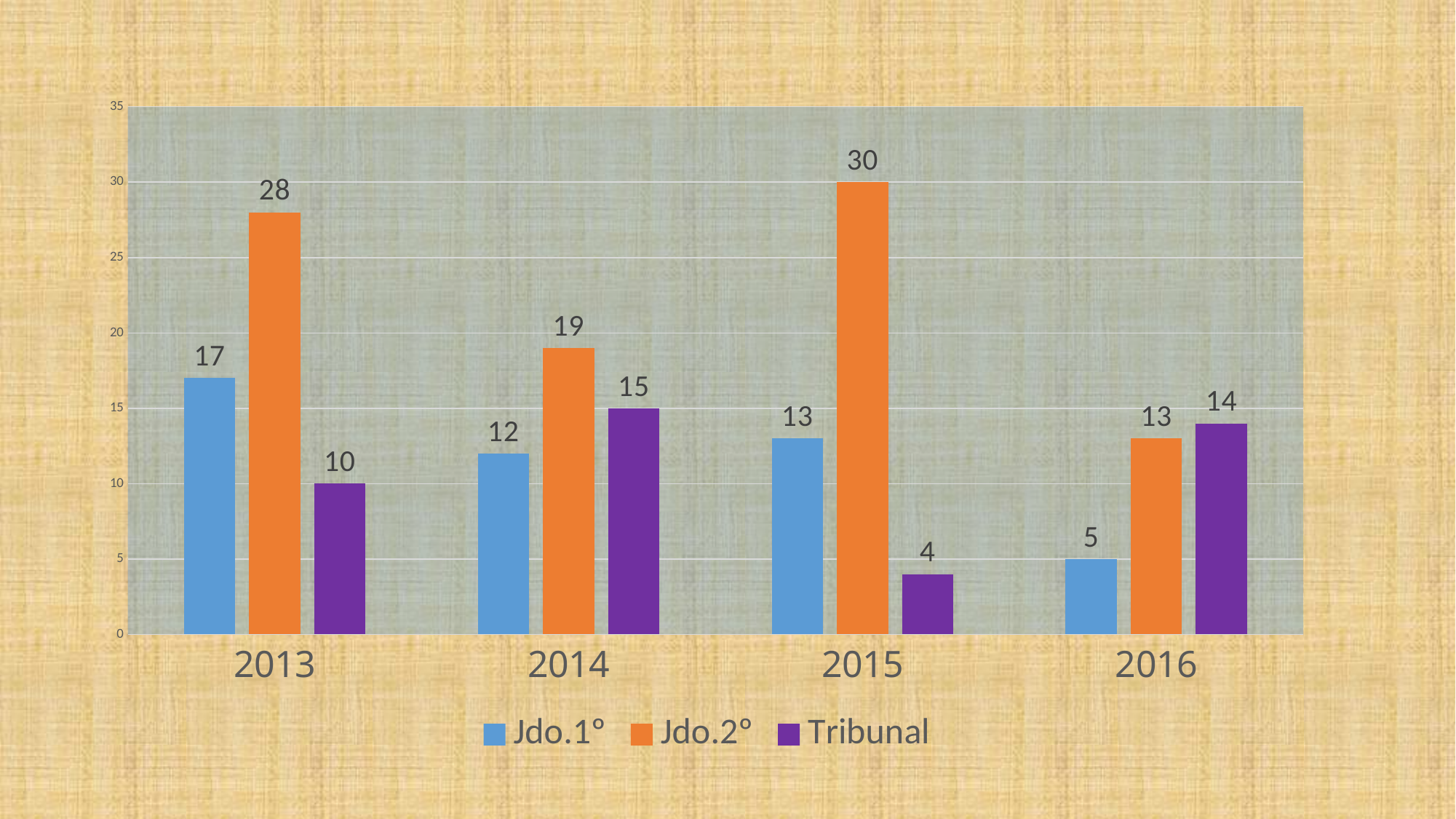
Which is larger in 2016, Jdo.2° or Tribunal? Tribunal In which year is the Tribunal value lowest? 2015 Is the value for Jdo.2° in 2014 greater or less than 20? less What is the difference between Jdo.2° and Jdo.1° in 2013? 11 What kind of chart is shown on the slide? bar chart Does the Jdo.1° value rise or fall from 2013 to 2016? fall What is the value for Tribunal in 2013? 10 How many years are shown on the x axis? 4 How many series does the legend list? 3 What is the value for Jdo.1° in 2016? 5 What is the value for Jdo.2° in 2015? 30 In which year is the Jdo.2° value highest? 2015